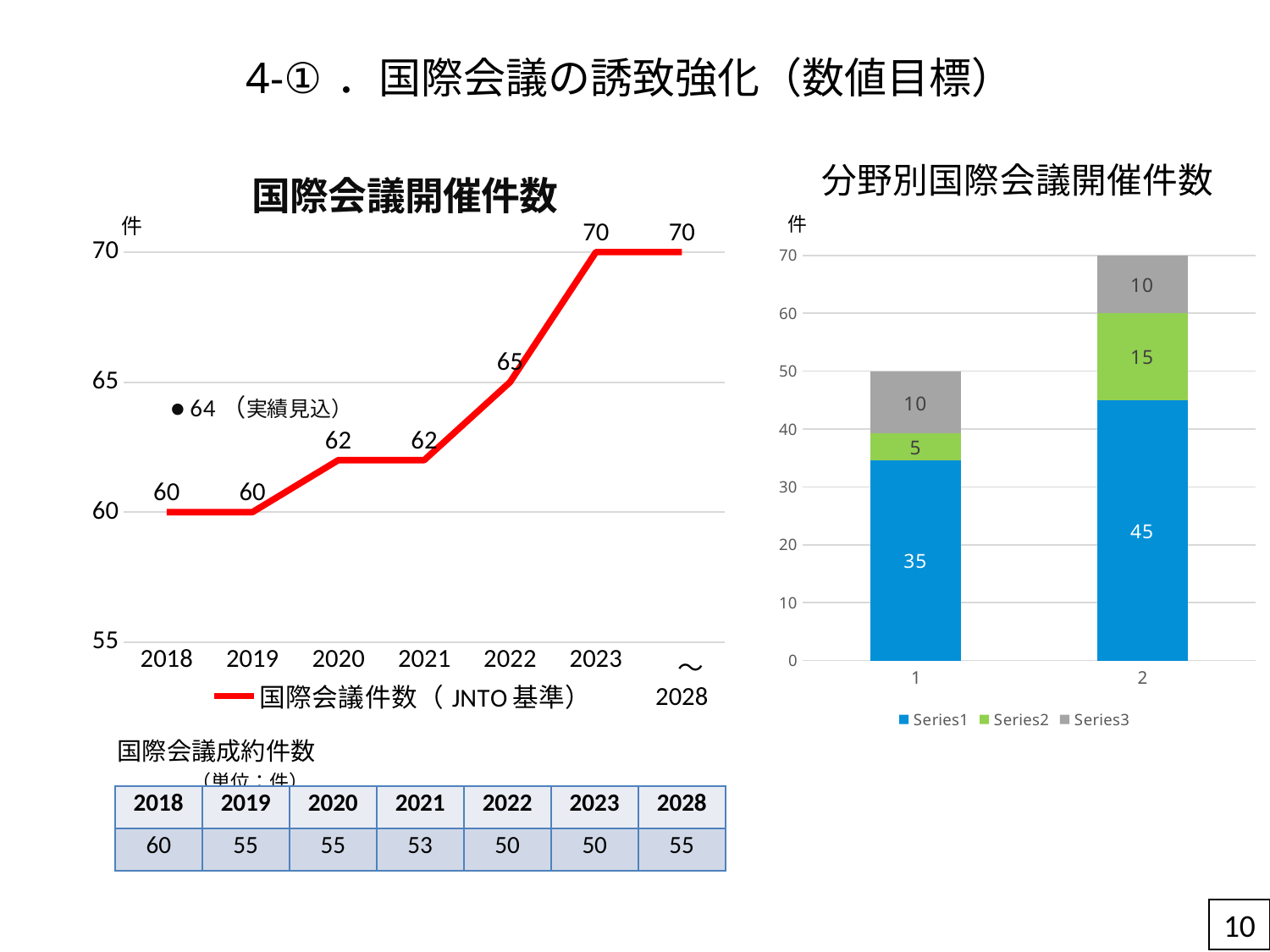
In the 分野別国際会議開催件数 chart, what is the Series1 value for category 2? 45 In the 国際会議開催件数 chart, what is the value for 2020? 62 In the 国際会議開催件数 chart, what is the value for 2018? 60 In the 分野別国際会議開催件数 chart, what is the total of the stacked bar for category 2? 70 What kind of chart is the 分野別国際会議開催件数 chart? stacked bar chart In the 国際会議開催件数 chart, do the values rise or fall from 2018 to 2023? rise In the 国際会議開催件数 chart, what is the value for 2022? 65 In the 国際会議開催件数 chart, what is the difference between the 2023 value and the 2018 value? 10 What kind of chart is the 国際会議開催件数 chart? line chart In the 分野別国際会議開催件数 chart, what is the total of the stacked bar for category 1? 50 In the 分野別国際会議開催件数 chart, what is the Series2 value for category 1? 5 How many series does the legend of the 分野別国際会議開催件数 chart list? 3